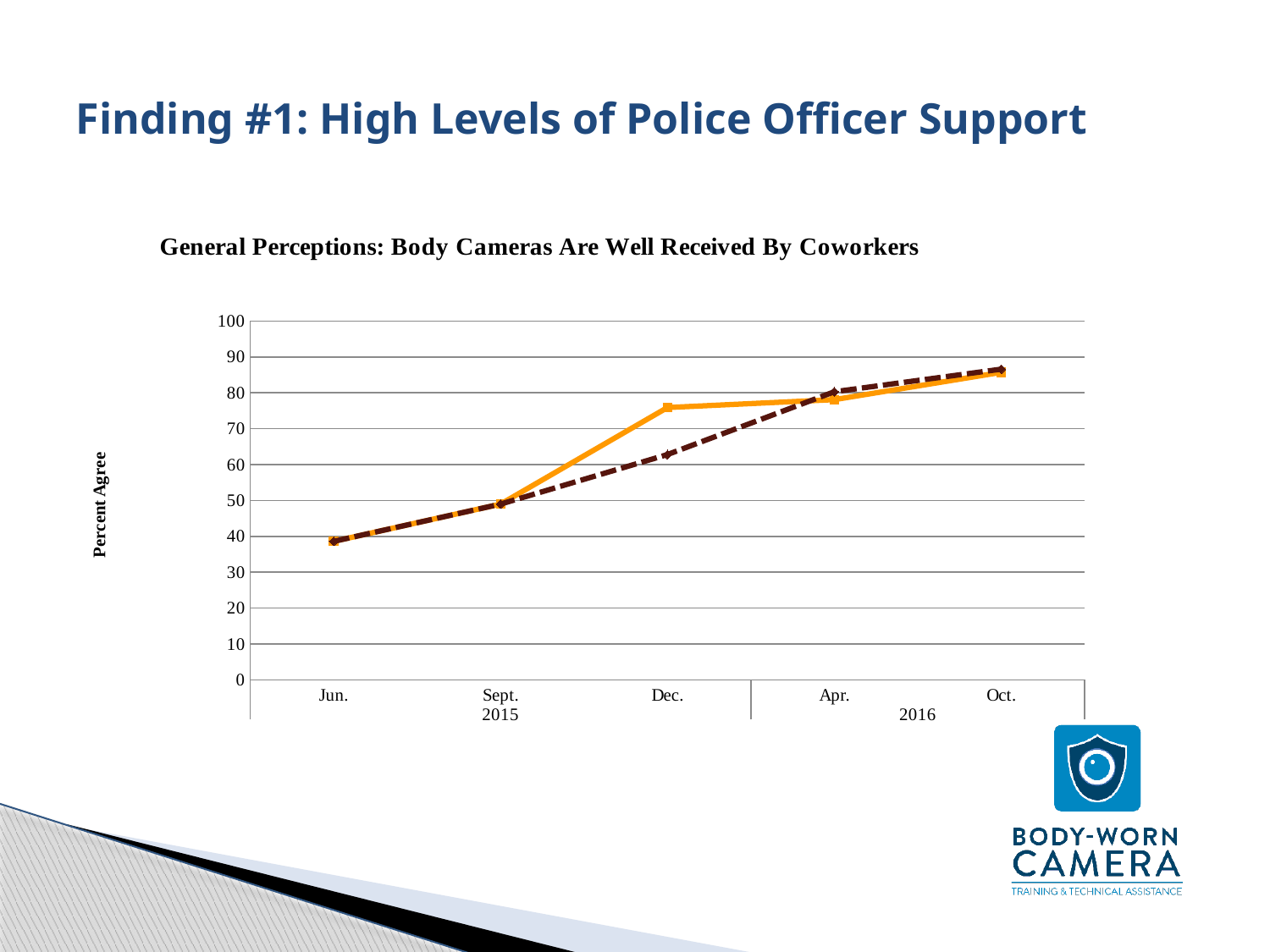
What is the title of the chart? General Perceptions: Body Cameras Are Well Received By Coworkers How many lines are plotted on the chart? 2 Is the value of the solid orange line at Dec. 2015 greater or less than 70? greater Is the value at Oct. 2016 greater or less than 80? greater Is the value of the dashed line at Dec. 2015 greater or less than 70? less At which time point does the chart reach its highest value? Oct. 2016 What is the label on the vertical axis of the chart? Percent Agree What kind of chart is shown on the slide? line chart Do the values rise or fall from Jun. 2015 to Oct. 2016? rise How many time points are plotted along the x axis? 5 At Dec. 2015, which line has the higher value, the solid orange line or the dashed line? the solid orange line